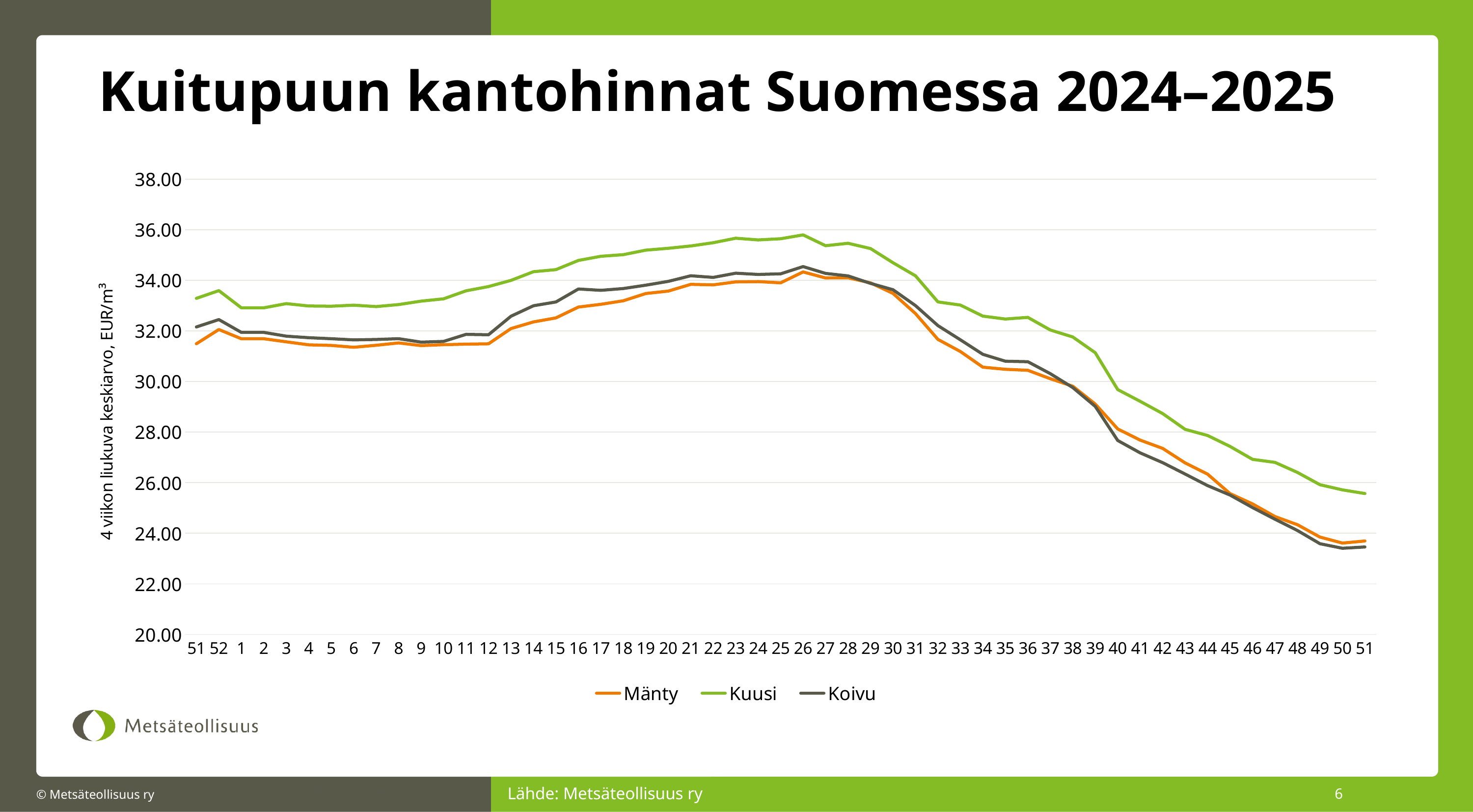
What kind of chart is shown on the slide? line chart Do the Kuusi values rise or fall from week 30 to the final week 51? fall Which series is plotted in green? Kuusi Which series has the lowest value at week 5? Mänty Is the value for Kuusi at week 1 greater or less than 32.00? greater Which series has the highest value at week 20? Kuusi What is the title of the chart? Kuitupuun kantohinnat Suomessa 2024–2025 Is the value for Kuusi at week 26 greater or less than 34.00? greater Is the value for Mänty at the final week 51 greater or less than 24.00? less How many series does the legend list? 3 At week 26, which is larger, Kuusi or Mänty? Kuusi